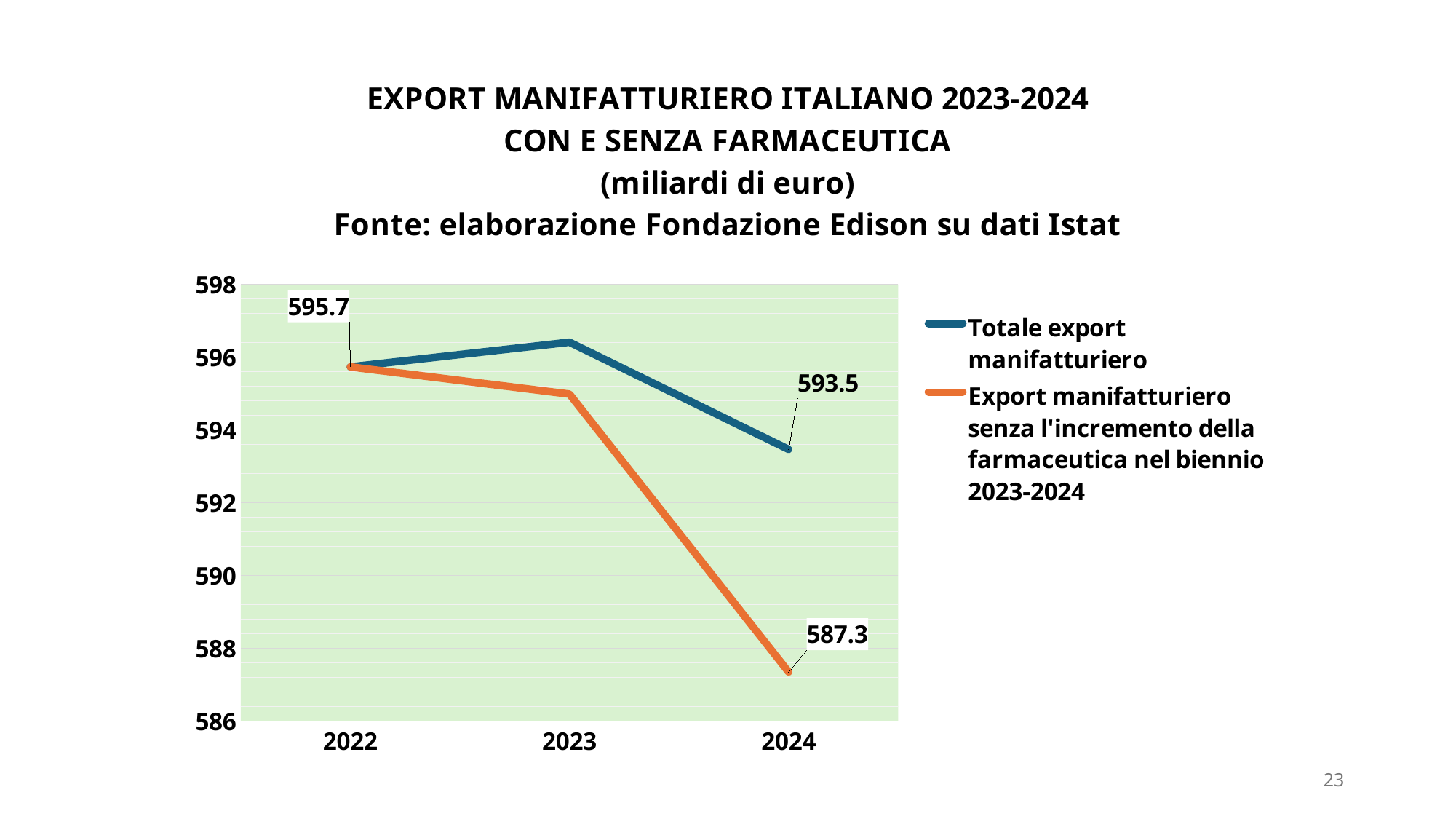
What is the difference between the two series' values in 2024? 6.1 What kind of chart is this? line chart How many years are shown on the x axis? 3 What is the value of Totale export manifatturiero in 2024? 593.5 What is the value of Export manifatturiero senza l'incremento della farmaceutica nel biennio 2023-2024 in 2024? 587.3 How many series does the legend list? 2 By how much did Export manifatturiero senza l'incremento della farmaceutica fall from 2022 to 2024? 8.4 Does the Export manifatturiero senza l'incremento della farmaceutica series rise or fall from 2022 to 2024? fall Is the 2023 value for Export manifatturiero senza l'incremento della farmaceutica greater or less than 596? less By how much did Totale export manifatturiero fall from 2022 to 2024? 2.3 What is the value shown for 2022? 595.7 In 2024, which series has the larger value? Totale export manifatturiero